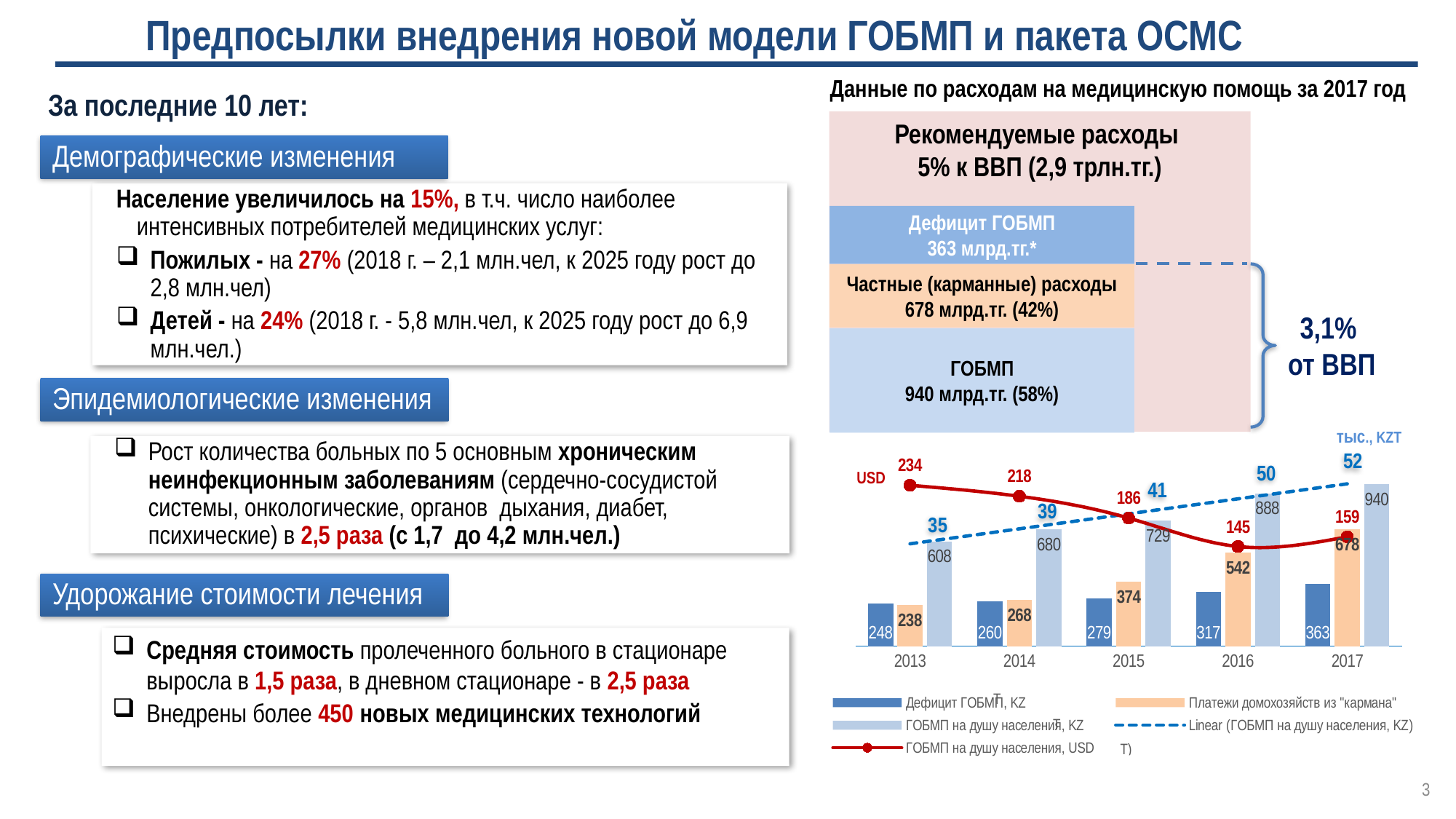
What is the difference between Платежи домохозяйств из "кармана" in 2017 and in 2013? 440 Does Дефицит ГОБМП rise or fall from 2013 to 2017? Rise What is the value of Дефицит ГОБМП for 2017? 363 How many entries does the chart legend list? 5 What is the value of ГОБМП на душу населения, KZ for 2014? 680 In which year is ГОБМП на душу населения, USD the lowest? 2016 Which is larger in 2016: Дефицит ГОБМП or Платежи домохозяйств из "кармана"? Платежи домохозяйств из "кармана" How many years are shown on the x axis of the chart? 5 What kind of chart is shown at the bottom right of the slide? Combined bar and line chart What is the value of Платежи домохозяйств из "кармана" for 2015? 374 In which year is ГОБМП на душу населения, KZ the highest? 2017 What is the value of ГОБМП на душу населения, USD for 2013? 234